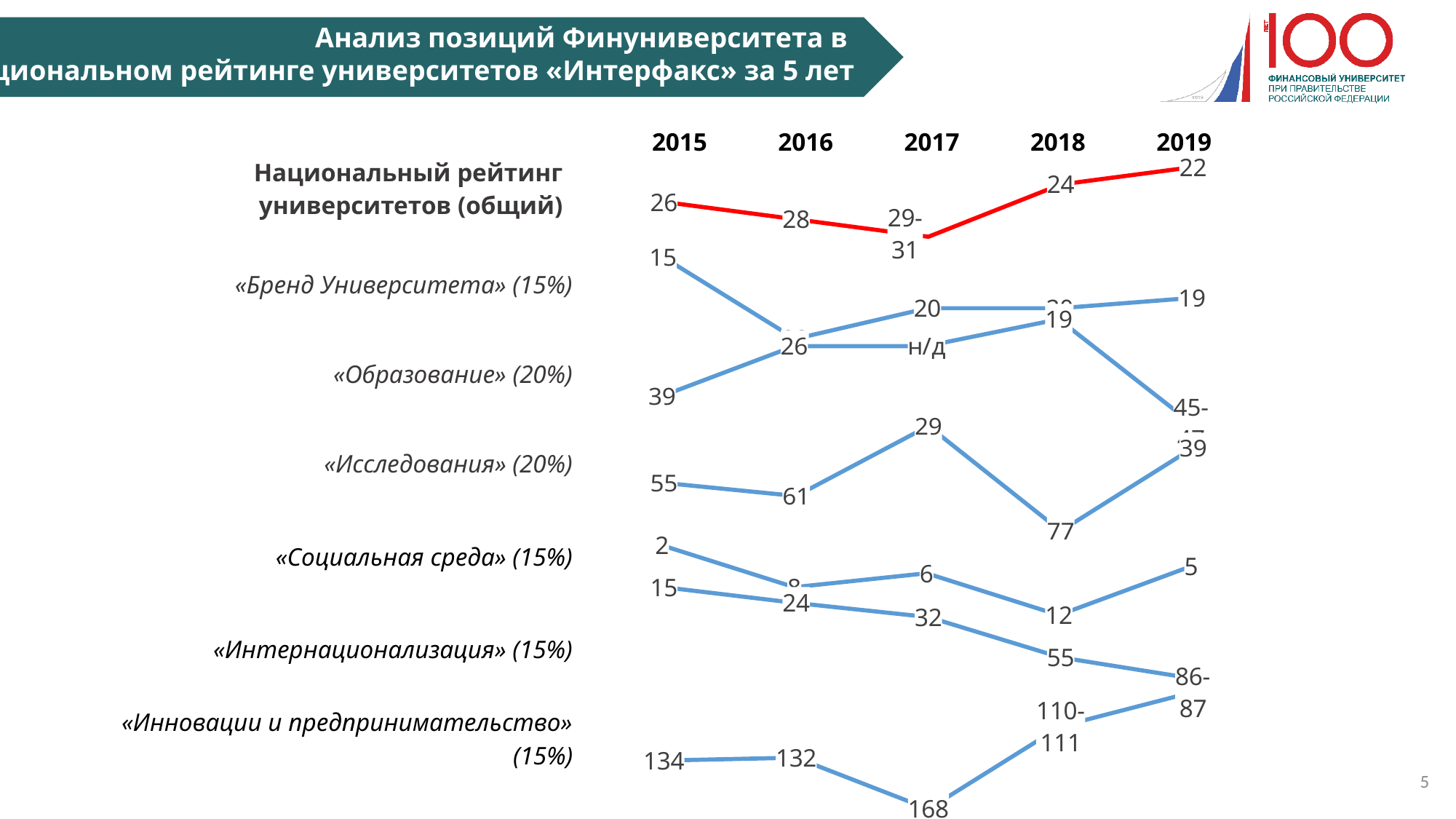
In the «Национальный рейтинг университетов (общий)» chart, what is the value for 2017? 29-31 In the «Инновации и предпринимательство» (15%) chart, which year has the highest value? 2017 In the «Интернационализация» (15%) chart, what is the value for 2018? 55 In the «Интернационализация» (15%) chart, do the values rise or fall from 2015 to 2019? rise In the «Исследования» (20%) chart, what is the value for 2018? 77 In the «Инновации и предпринимательство» (15%) chart, what is the value for 2015? 134 In the «Национальный рейтинг университетов (общий)» chart, which is larger, the value for 2015 or for 2019? 2015 In the «Исследования» (20%) chart, what is the difference between the 2018 and 2017 values? 48 In the «Национальный рейтинг университетов (общий)» chart, what is the value for 2019? 22 In the «Социальная среда» (15%) chart, which year has the highest value? 2018 In the «Исследования» (20%) chart, which year has the lowest value? 2017 How many years are shown on the x axis of the charts? 5